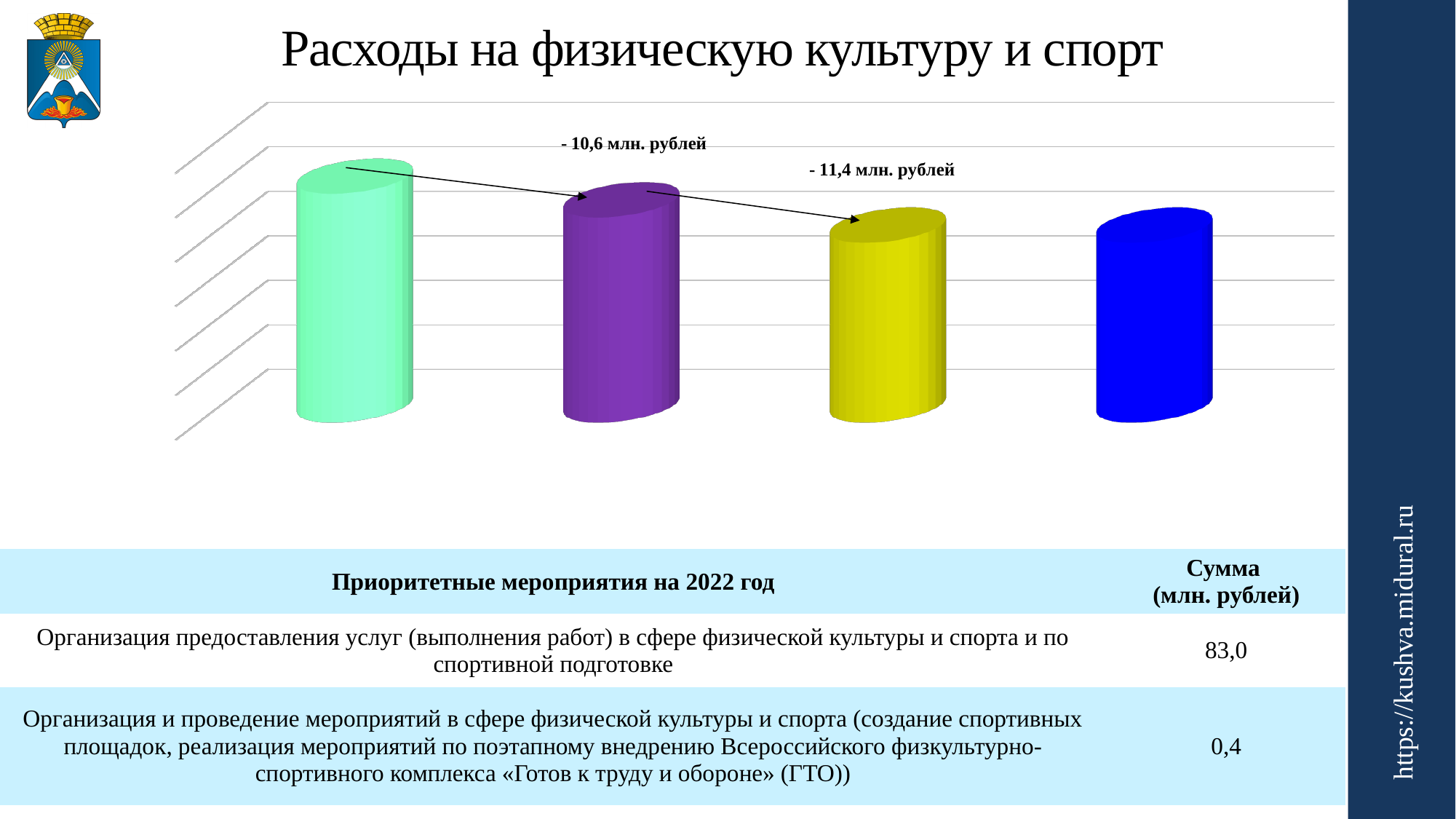
What colour is the fourth (rightmost) bar in the chart? blue What is the title of the slide containing the chart? Расходы на физическую культуру и спорт What kind of chart is shown on the slide? bar chart What change is annotated between the first and second bars? - 10,6 млн. рублей Is the first (light green) bar taller or shorter than the second (purple) bar? taller Do the values rise or fall from the first bar to the third bar? fall Is the second (purple) bar taller or shorter than the third (yellow) bar? taller Which bar is the tallest in the chart? the first (leftmost, light green) bar What change is annotated between the second and third bars? - 11,4 млн. рублей Which of the two annotated decreases is larger: the one between the first and second bars, or the one between the second and third bars? between the second and third bars (11,4 млн. рублей) How many bars does the chart contain? 4